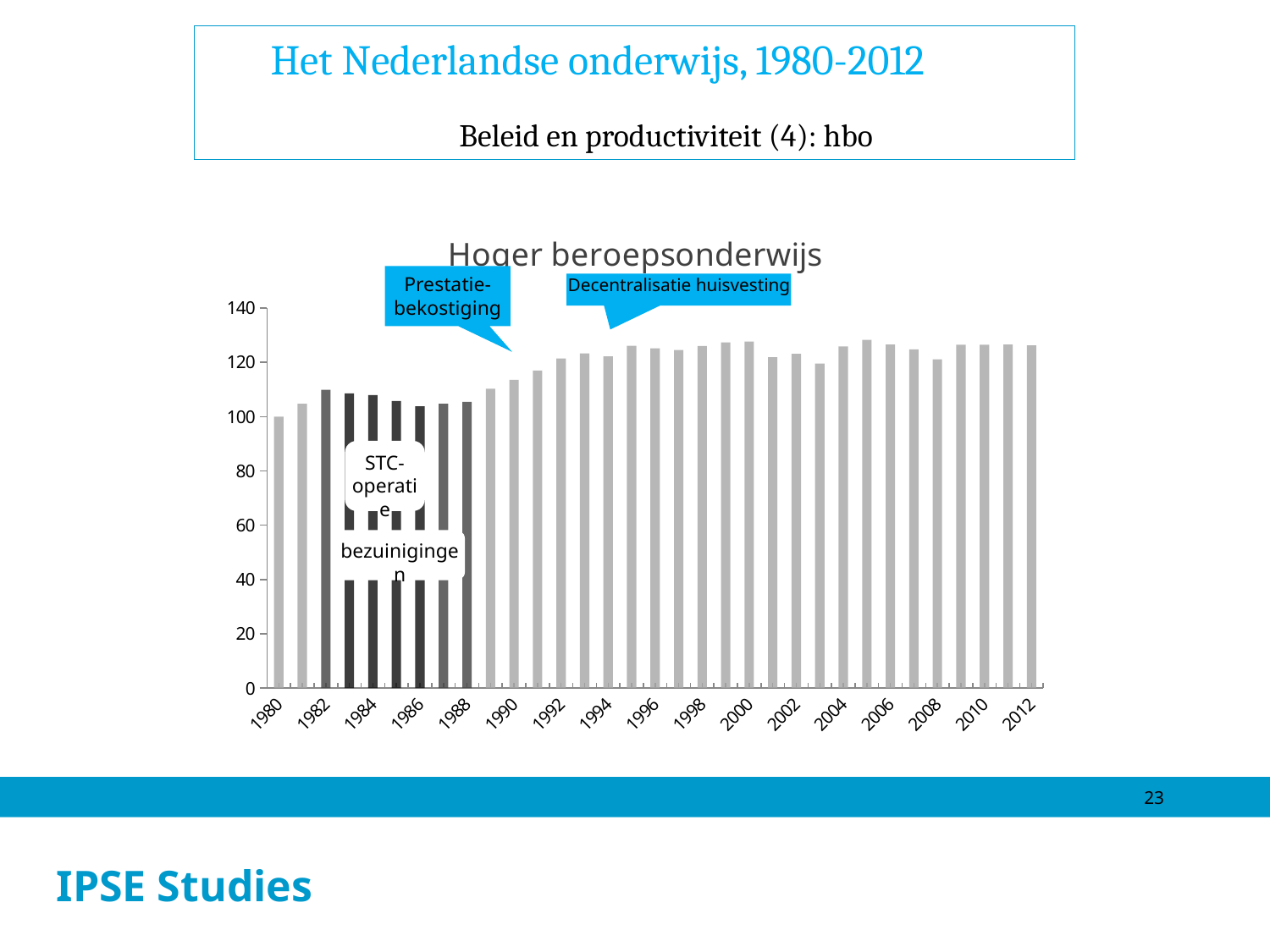
Is the value for 2006 greater or less than 120? greater Which policy annotation points to the bars around 1994? Decentralisatie huisvesting Is the value for 2000 greater or less than 120? greater Do the values rise or fall from 1988 to 2000? rise Is the value for 1990 greater or less than 100? greater Which year has the lowest value in the chart? 1980 What is the value for 1980? 100 Which year has the larger value, 1980 or 2012? 2012 What is the title of the chart? Hoger beroepsonderwijs What kind of chart is shown on the slide? bar chart How many years (bars) are plotted in the chart? 33